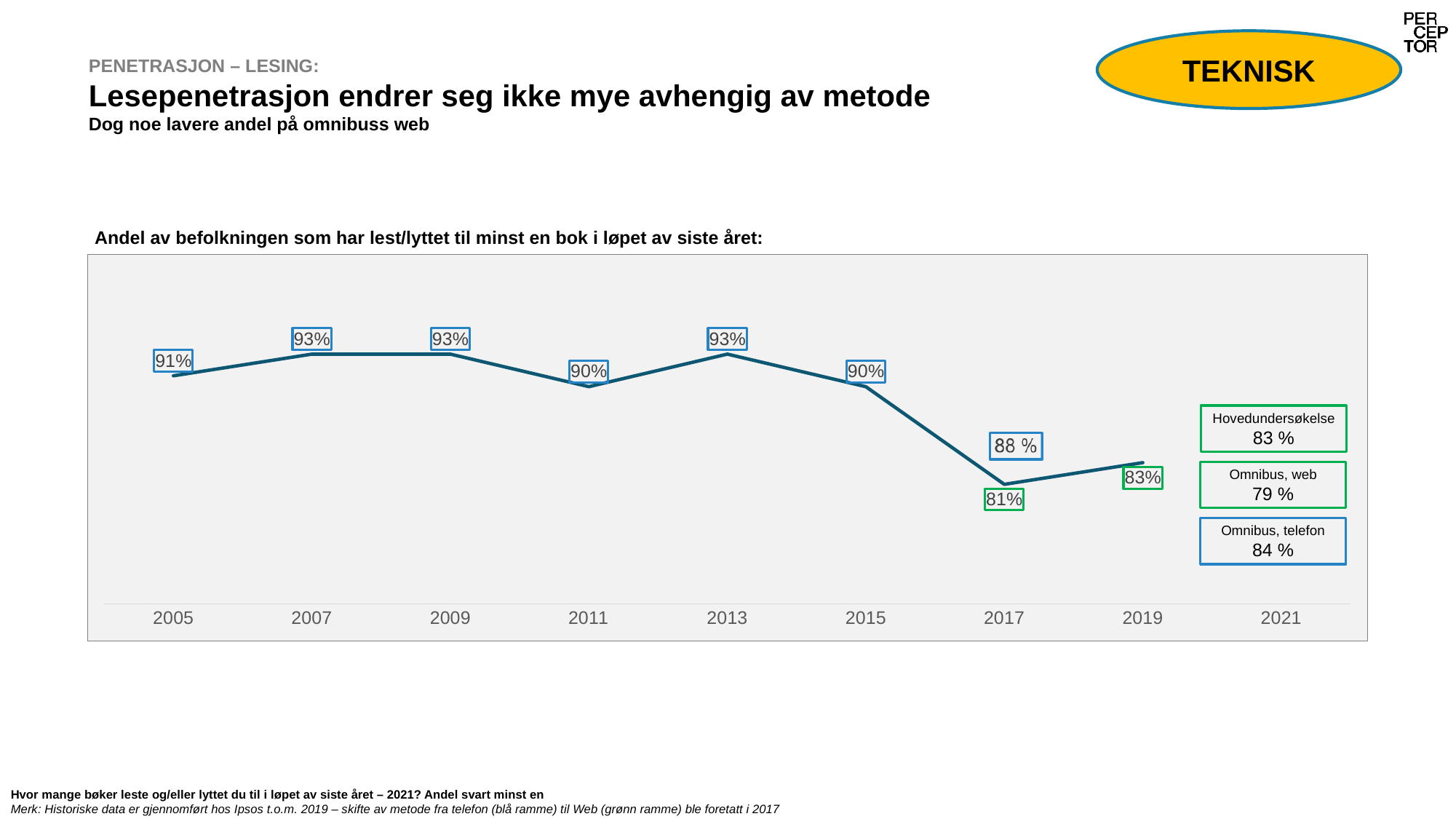
Which year has the larger value, 2013 or 2015? 2013 What is the value for 2019? 83% What is the difference between the values for 2007 and 2005? 2 percentage points What kind of chart is shown on the slide? line chart What is the value for 2011? 90% What is the value for 2005? 91% What is the green-framed (web) value for 2017? 81% What is the 2021 value for 'Omnibus, telefon'? 84 % Which year has the lowest value on the line? 2017 How many years are shown on the x axis? 9 What is the blue-framed (telephone) value for 2017? 88 % What is the 2021 value for 'Omnibus, web'? 79 %